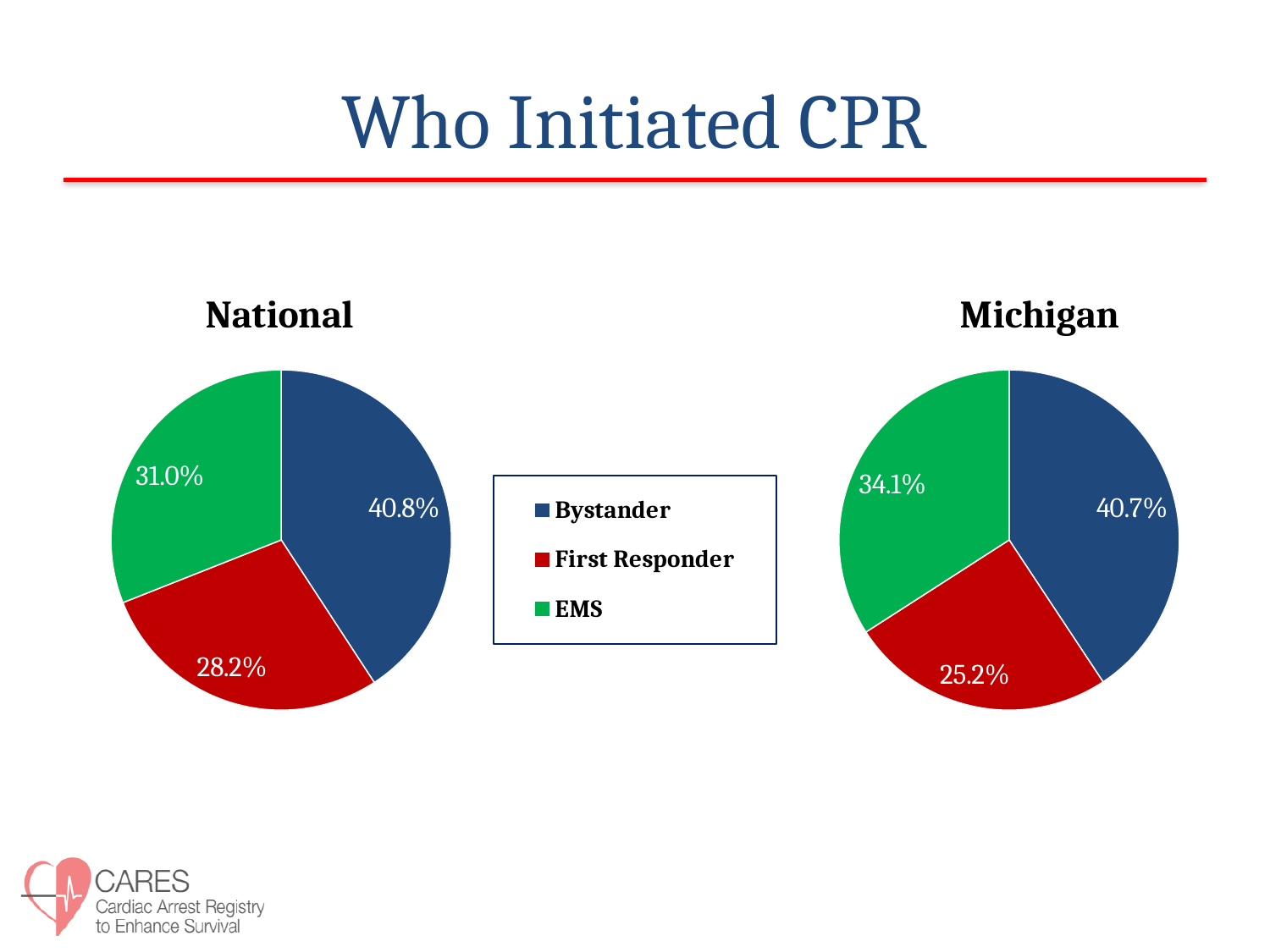
What is the difference between the EMS share in the Michigan chart and the EMS share in the National chart? 3.1% In the Michigan pie chart, what share of CPR was initiated by EMS? 34.1% In the National pie chart, what share of CPR was initiated by First Responders? 28.2% In the Michigan pie chart, what share of CPR was initiated by First Responders? 25.2% In the National pie chart, which category has the smallest share? First Responder In the National pie chart, what share of CPR was initiated by Bystanders? 40.8% Which is larger: the First Responder share in the National chart or in the Michigan chart? National How many categories does the legend list? 3 How many slices does the National pie chart have? 3 In the Michigan pie chart, which category has the largest share? Bystander What colour represents EMS in the pie charts? Green What type of chart is used for the Michigan data? Pie chart